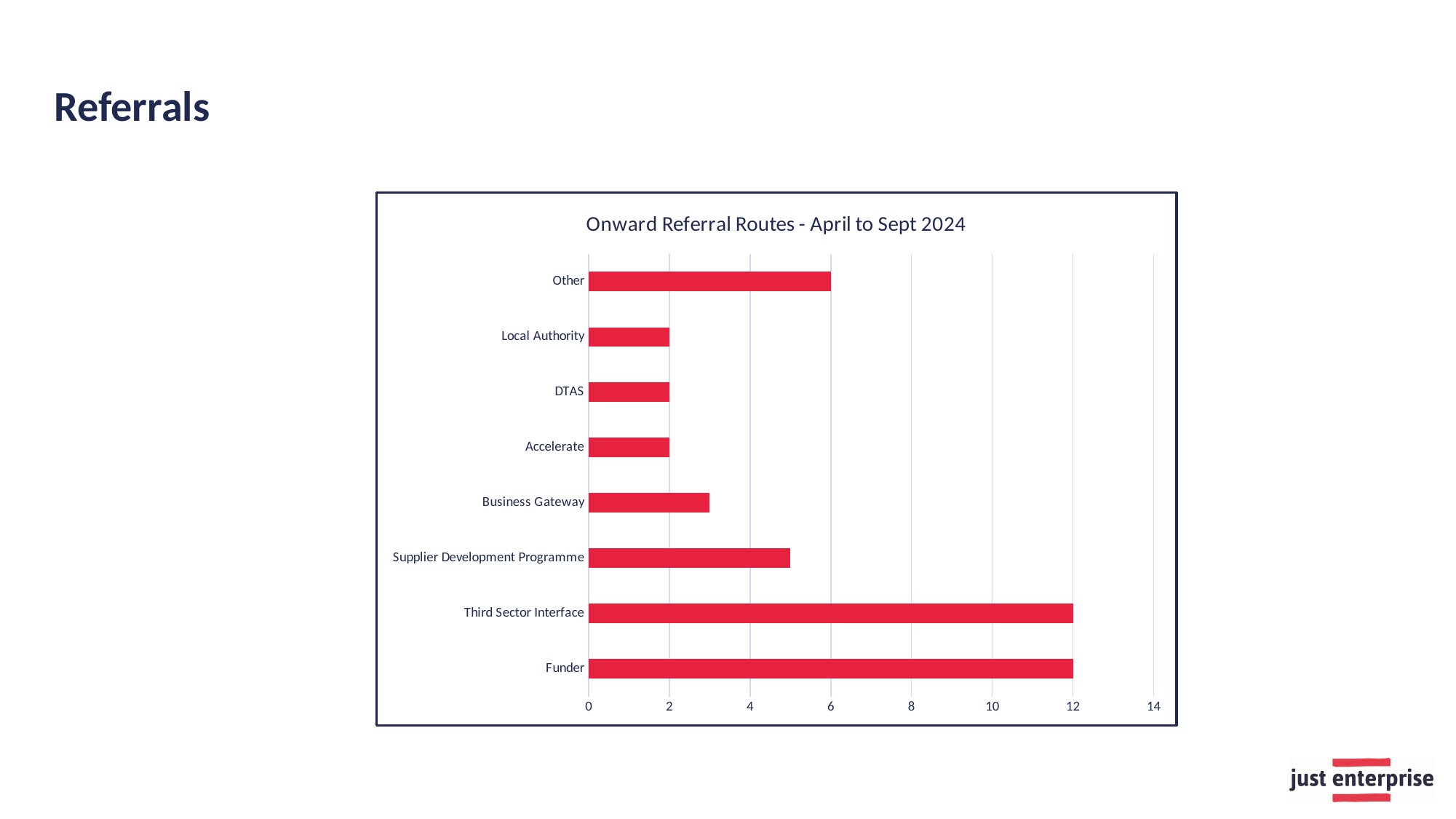
What kind of chart is shown on the slide? Bar chart Which is larger, the value for Other or the value for Accelerate? Other What is the difference between the value for Funder and the value for Other? 6 What is the value for Other in the Onward Referral Routes chart? 6 What is the value for Third Sector Interface? 12 What is the value for DTAS? 2 What is the title of the chart? Onward Referral Routes - April to Sept 2024 What is the value for Local Authority? 2 How many referral route categories are shown in the chart? 8 What is the value for Funder? 12 Is the value for Business Gateway greater or less than 4? less Is the value for Supplier Development Programme greater or less than 4? greater